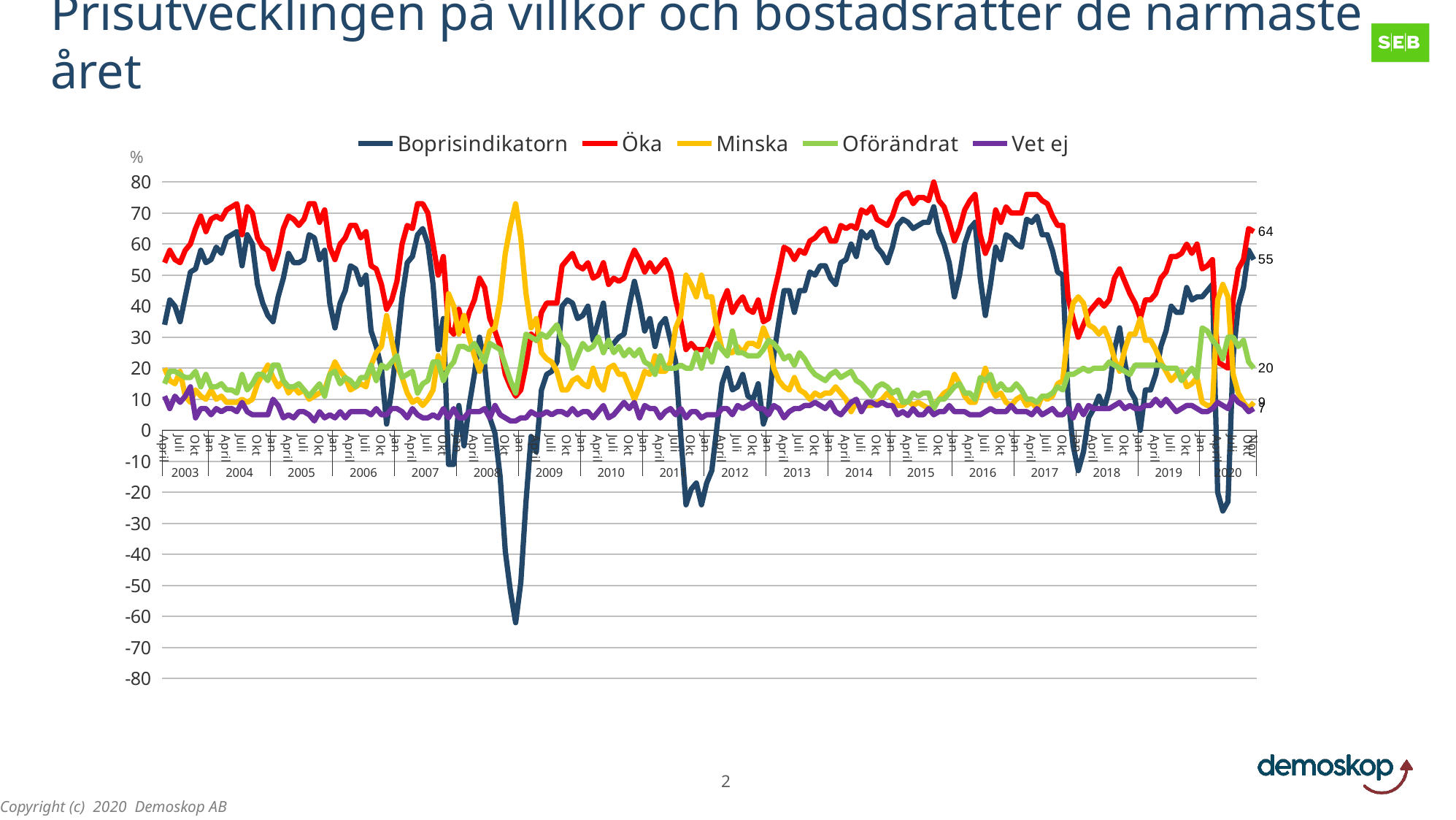
What is the latest value shown for the Oförändrat series? 20 What is the latest value shown for the Vet ej series? 7 How many series does the legend list? 5 What is the latest value shown for Boprisindikatorn? 55 What colour is the Öka series line in the legend? red At the latest data point, what is the difference between Öka and Boprisindikatorn? 9 Is the peak of the Öka series in 2015 greater or less than 70? greater Which series has the lowest value at the latest data point? Vet ej At the latest data point, which is larger: Öka or Oförändrat? Öka What is the latest value shown for the Öka series? 64 Is the lowest value of Boprisindikatorn, reached around the start of 2009, greater or less than -50? less What kind of chart is shown on the slide? line chart